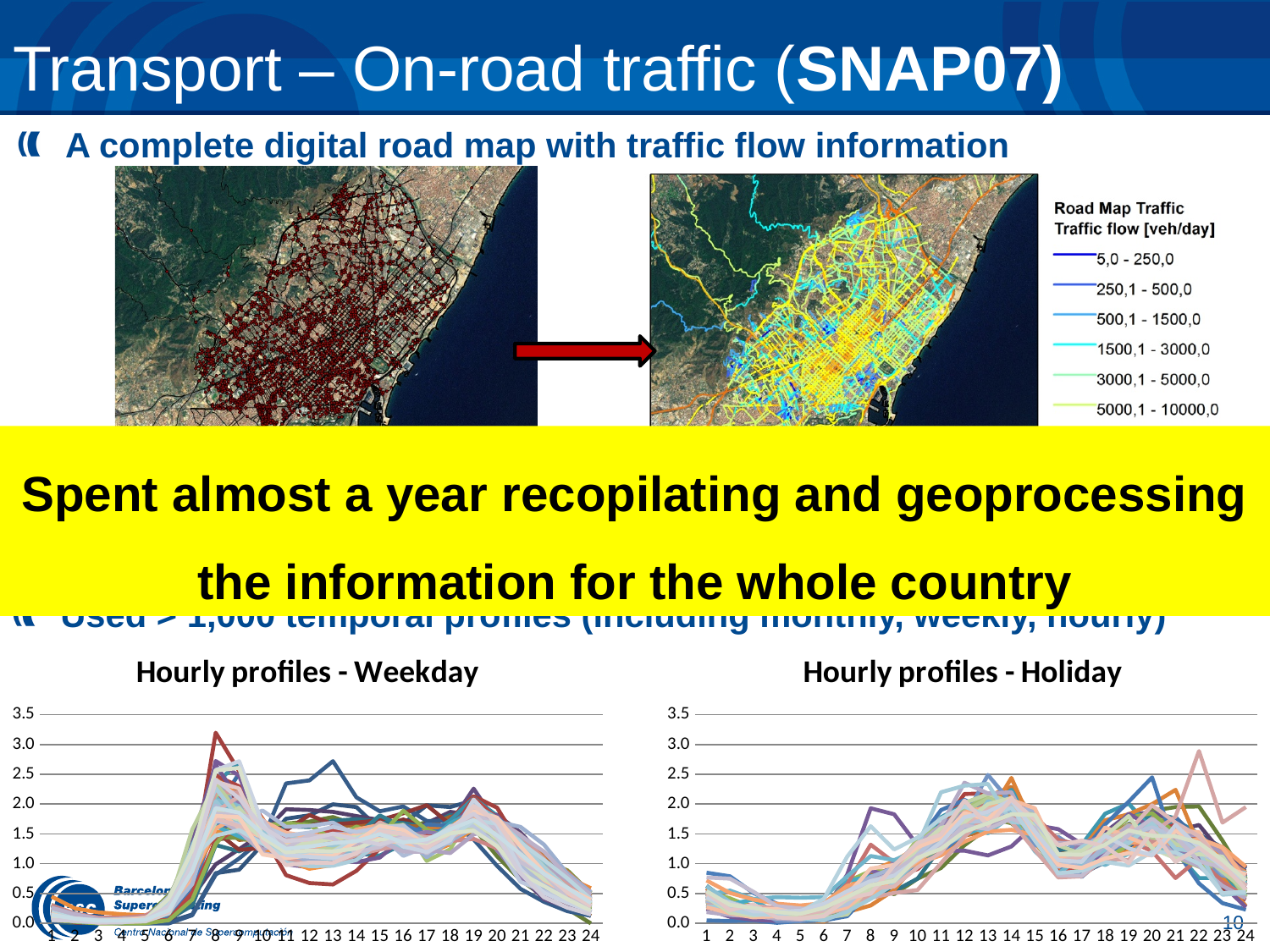
What is the title of the line chart on the left of the slide? Hourly profiles - Weekday In the 'Hourly profiles - Weekday' chart, is the highest peak of any line greater or less than 3.0? greater In the 'Hourly profiles - Holiday' chart, are the values at hour 3 greater or less than 1.0? less What kind of chart is the 'Hourly profiles - Holiday' chart? line chart In the 'Hourly profiles - Holiday' chart, is the highest peak of any line greater or less than 3.0? less What kind of chart is the 'Hourly profiles - Weekday' chart? line chart How many hourly points are shown along the x axis of the 'Hourly profiles - Holiday' chart? 24 How many hourly points are shown along the x axis of the 'Hourly profiles - Weekday' chart? 24 What is the highest tick value shown on the y axis of the 'Hourly profiles - Holiday' chart? 3.5